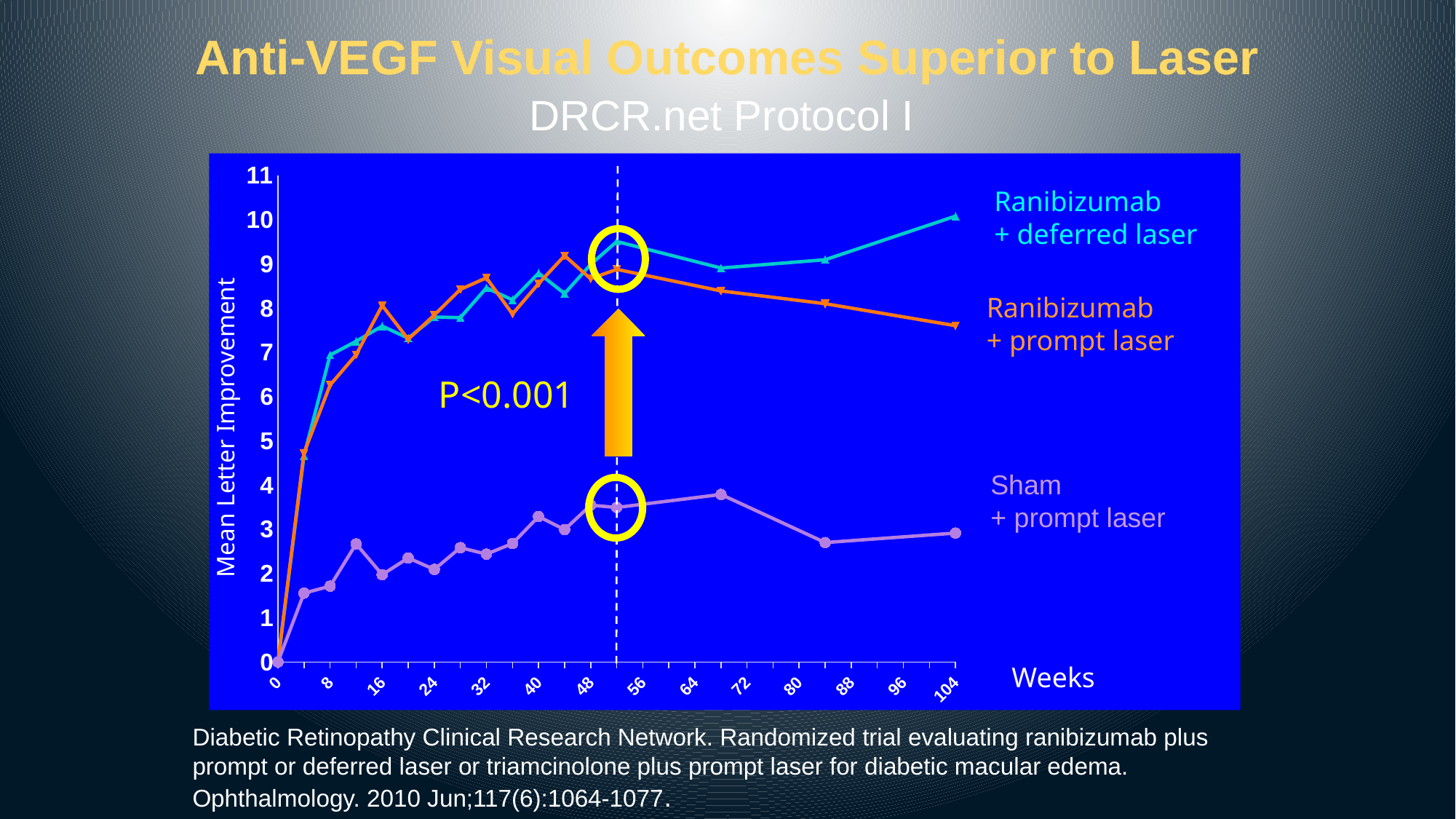
Which series has the lowest mean letter improvement at week 104? Sham + prompt laser Is the value for Ranibizumab + deferred laser at week 104 greater or less than 9? greater Which series has the highest mean letter improvement at week 104? Ranibizumab + deferred laser How many series are plotted on the chart? 3 What P value is printed on the chart? P<0.001 Is the value for Sham + prompt laser at week 104 greater or less than 4? less Does the Ranibizumab + prompt laser line rise or fall between week 52 and week 104? fall What is the mean letter improvement for all three series at week 0? 0 What kind of chart is shown on the slide? line chart Does the Ranibizumab + deferred laser line rise or fall between week 68 and week 104? rise At week 104, which is higher: Ranibizumab + deferred laser or Ranibizumab + prompt laser? Ranibizumab + deferred laser Is the value for Ranibizumab + prompt laser at week 104 greater or less than 8? less